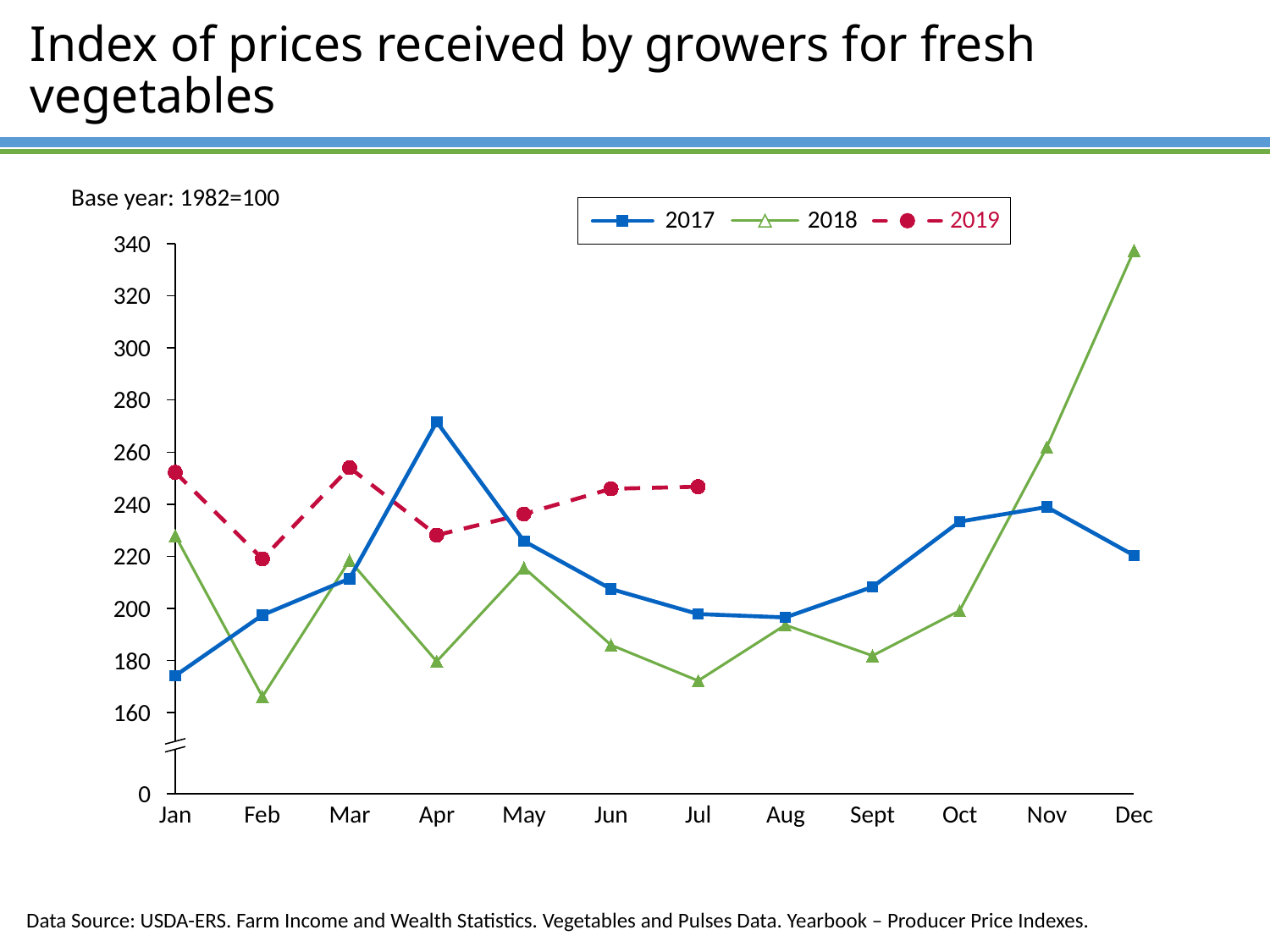
Is the value for 2018 in Dec greater or less than 320? greater How many series does the legend list? 3 In Jan, which series has the larger value, 2017 or 2019? 2019 What kind of chart is shown on the slide? line chart Does the 2018 series rise or fall from Sept to Dec? rise In which month does the 2017 series reach its highest value? Apr How many data points are plotted for the 2019 series? 7 In which month does the 2018 series reach its highest value? Dec In which month does the 2018 series reach its lowest value? Feb In which month does the 2017 series reach its lowest value? Jan How many months are shown along the x axis? 12 Is the value for 2017 in Jan greater or less than 180? less